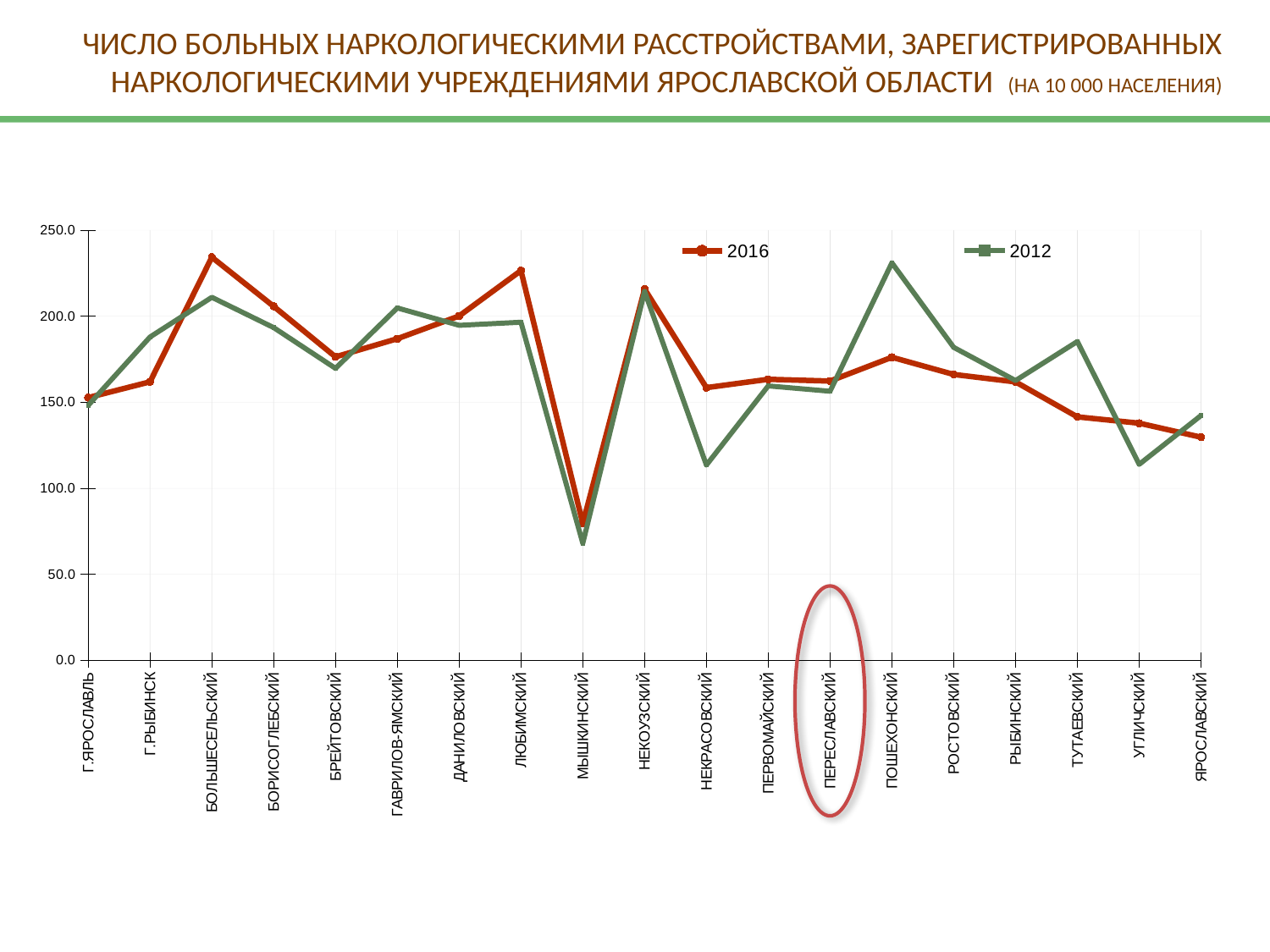
Which category has the highest value for the 2012 series? ПОШЕХОНСКИЙ Which category on the x axis is highlighted with a red oval? ПЕРЕСЛАВСКИЙ For МЫШКИНСКИЙ, which series has the larger value, 2012 or 2016? 2016 Is the 2016 value for БОЛЬШЕСЕЛЬСКИЙ greater or less than 200.0? greater How many series does the legend list? 2 For ТУТАЕВСКИЙ, which series has the larger value, 2012 or 2016? 2012 Is the 2012 value for ПОШЕХОНСКИЙ greater or less than 200.0? greater What kind of chart is shown on the slide? line chart Is the 2012 value for НЕКРАСОВСКИЙ greater or less than 150.0? less Which category has the lowest value for the 2016 series? МЫШКИНСКИЙ How many categories (districts) are plotted along the x axis? 19